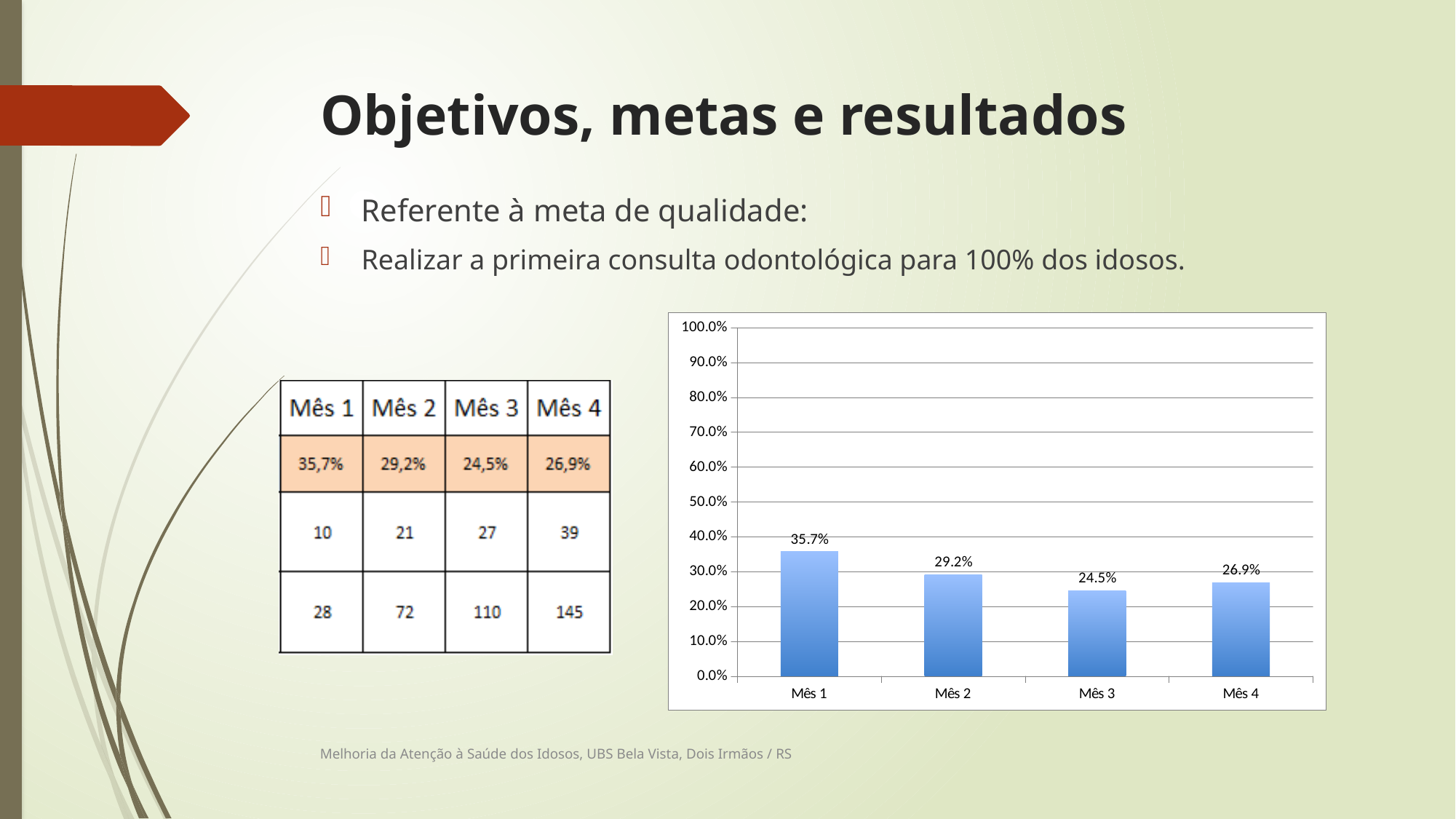
What is the difference between the values for Mês 1 and Mês 2? 6.5% What is the value for Mês 4 in the bar chart? 26.9% Which is larger, the value for Mês 2 or the value for Mês 4? Mês 2 Which month has the highest value in the bar chart? Mês 1 Which month has the lowest value in the bar chart? Mês 3 What is the difference between the values for Mês 4 and Mês 3? 2.4% How many months are shown on the x axis of the bar chart? 4 What is the value for Mês 3 in the bar chart? 24.5% Is the value for Mês 1 greater or less than 30.0%? greater What is the value for Mês 1 in the bar chart? 35.7% What kind of chart is shown on the slide? Bar chart What is the highest value shown on the y axis of the bar chart? 100.0%